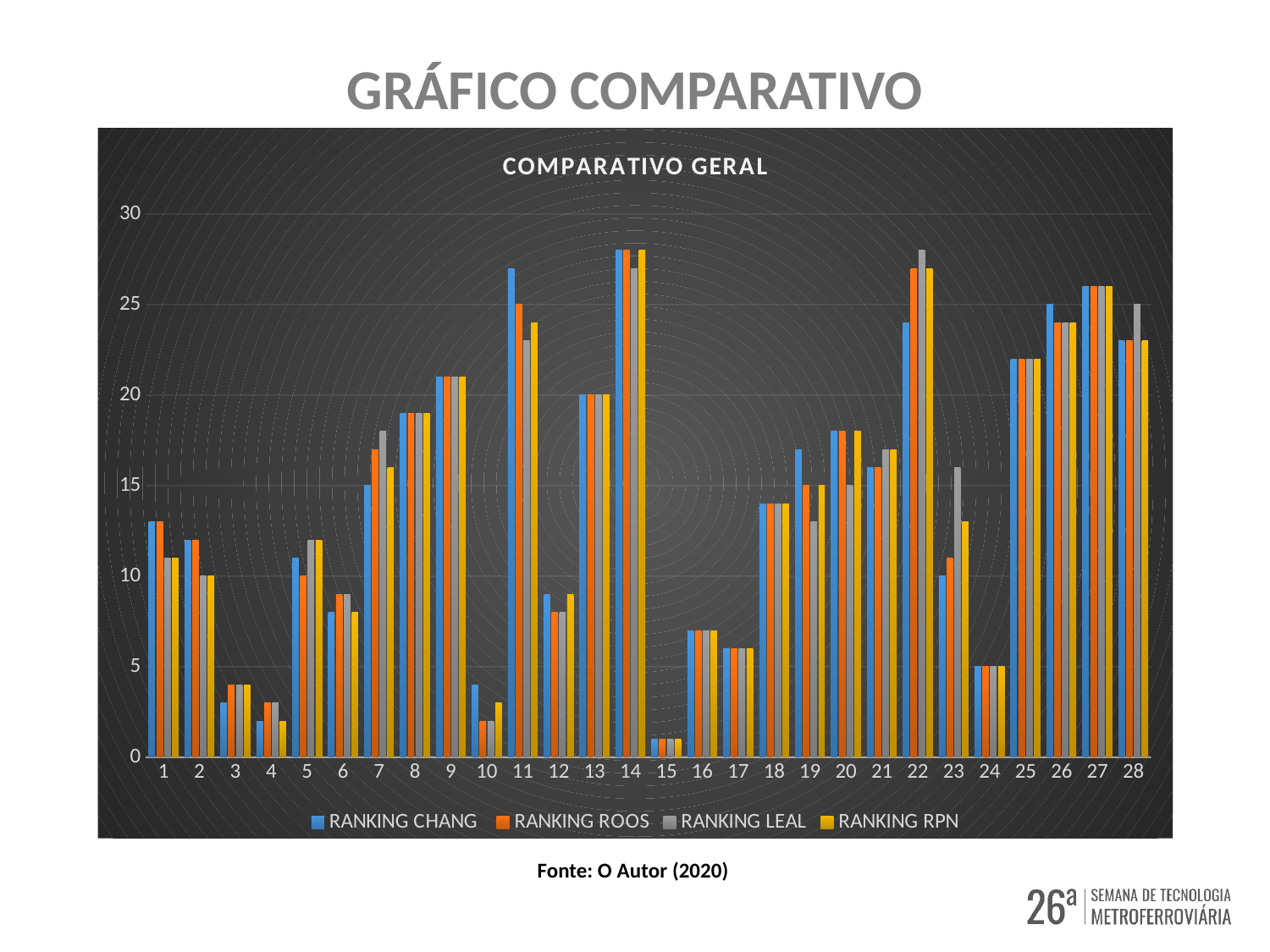
For RANKING LEAL, which is larger: category 22 or category 23? category 22 What is the value for RANKING CHANG at category 24? 5 Is the value for RANKING RPN at category 4 greater or less than 5? less Is the value for RANKING LEAL at category 9 greater or less than 20? greater Which series is shown in orange in the legend? RANKING ROOS What kind of chart is shown on the slide? bar chart Which category has the lowest value for RANKING CHANG? 15 What is the title of the chart? COMPARATIVO GERAL How many categories are shown along the x axis? 28 How many series does the legend list? 4 Is the value for RANKING ROOS at category 15 greater or less than 5? less